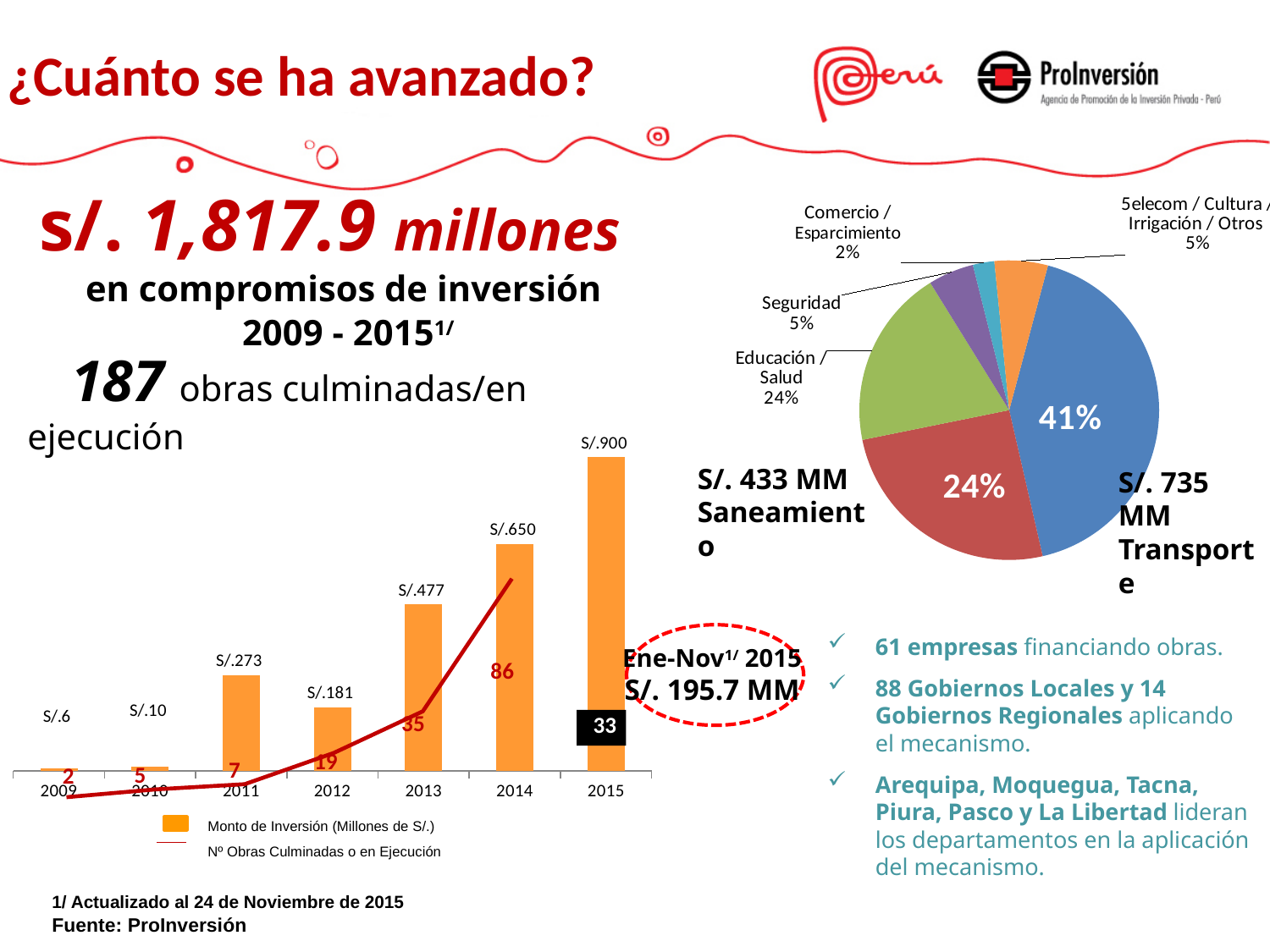
In the pie chart of investment by sector, which sector has the smallest share? Comercio / Esparcimiento In the bar chart of investment by year, how many years are shown on the x axis? 7 In the pie chart of investment by sector, what share does Transporte have? 41% In the bar chart of investment by year, how many series does the legend list? 2 In the bar chart of investment by year, what is the investment amount (Monto de Inversión) for 2015? S/.900 In the bar chart of investment by year, which year has the lowest investment amount? 2009 In the bar chart of investment by year, what is the investment amount for 2012? S/.181 In the pie chart of investment by sector, what share does Seguridad have? 5% In the bar chart of investment by year, what is the difference between the investment amounts for 2014 and 2013? S/.173 In the bar chart of investment by year, which year has the highest investment amount? 2015 In the bar chart of investment by year, how many works (Nº Obras Culminadas o en Ejecución) are shown for 2014? 86 In the bar chart of investment by year, which is larger: the investment amount for 2011 or for 2012? 2011